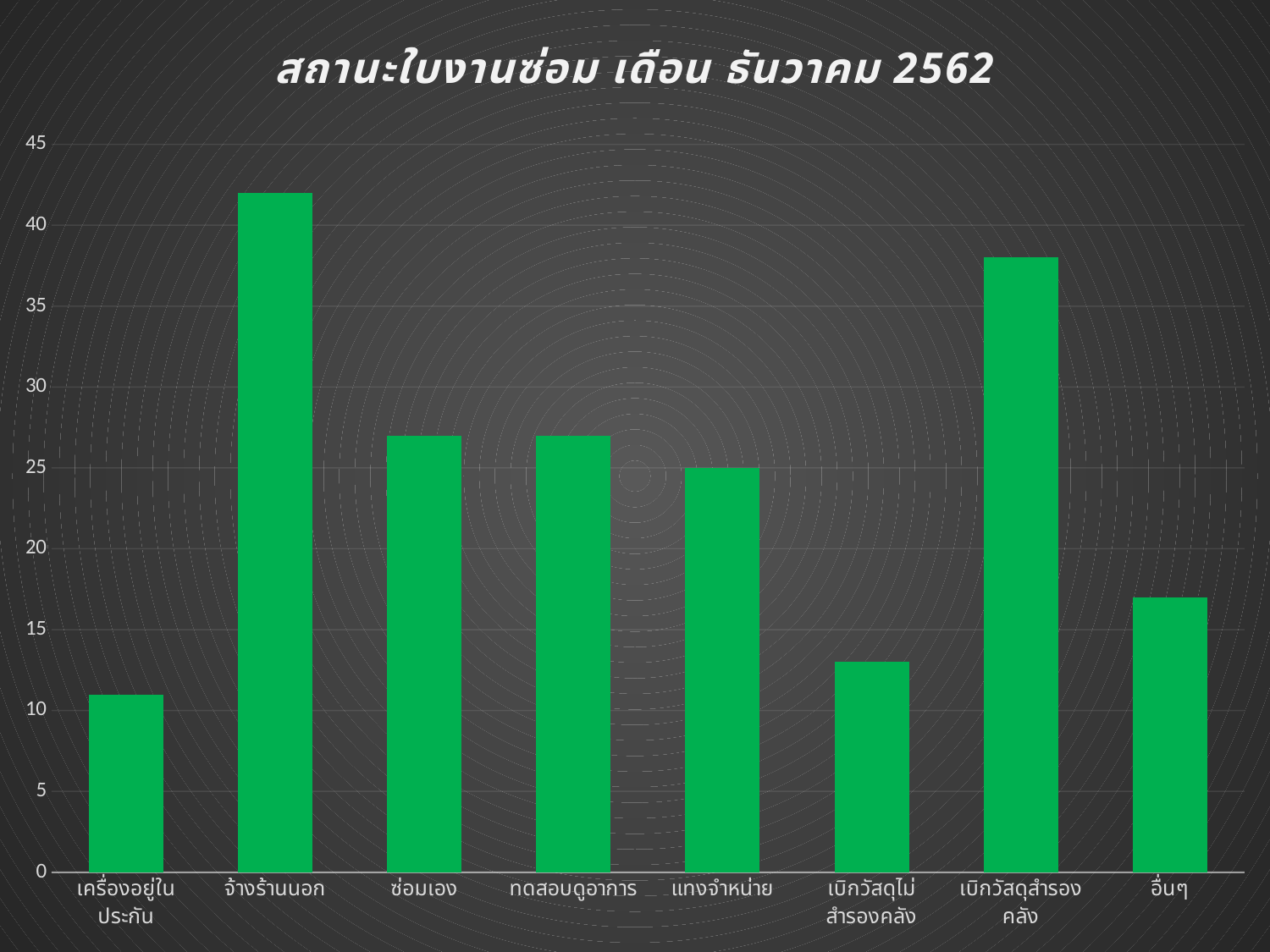
Which is larger, the value for เบิกวัสดุไม่สำรองคลัง or the value for อื่นๆ? อื่นๆ Which category has the highest value? จ้างร้านนอก What is the title of the chart? สถานะใบงานซ่อม เดือน ธันวาคม 2562 Which category has the lowest value? เครื่องอยู่ในประกัน Which is larger, the value for จ้างร้านนอก or the value for เบิกวัสดุสำรองคลัง? จ้างร้านนอก Is the value for อื่นๆ greater or less than 20? less Is the value for จ้างร้านนอก greater or less than 40? greater How many categories are shown on the x axis of the chart? 8 Is the value for เบิกวัสดุสำรองคลัง greater or less than 40? less What is the value for แทงจำหน่าย? 25 What type of chart is shown on the slide? Bar chart